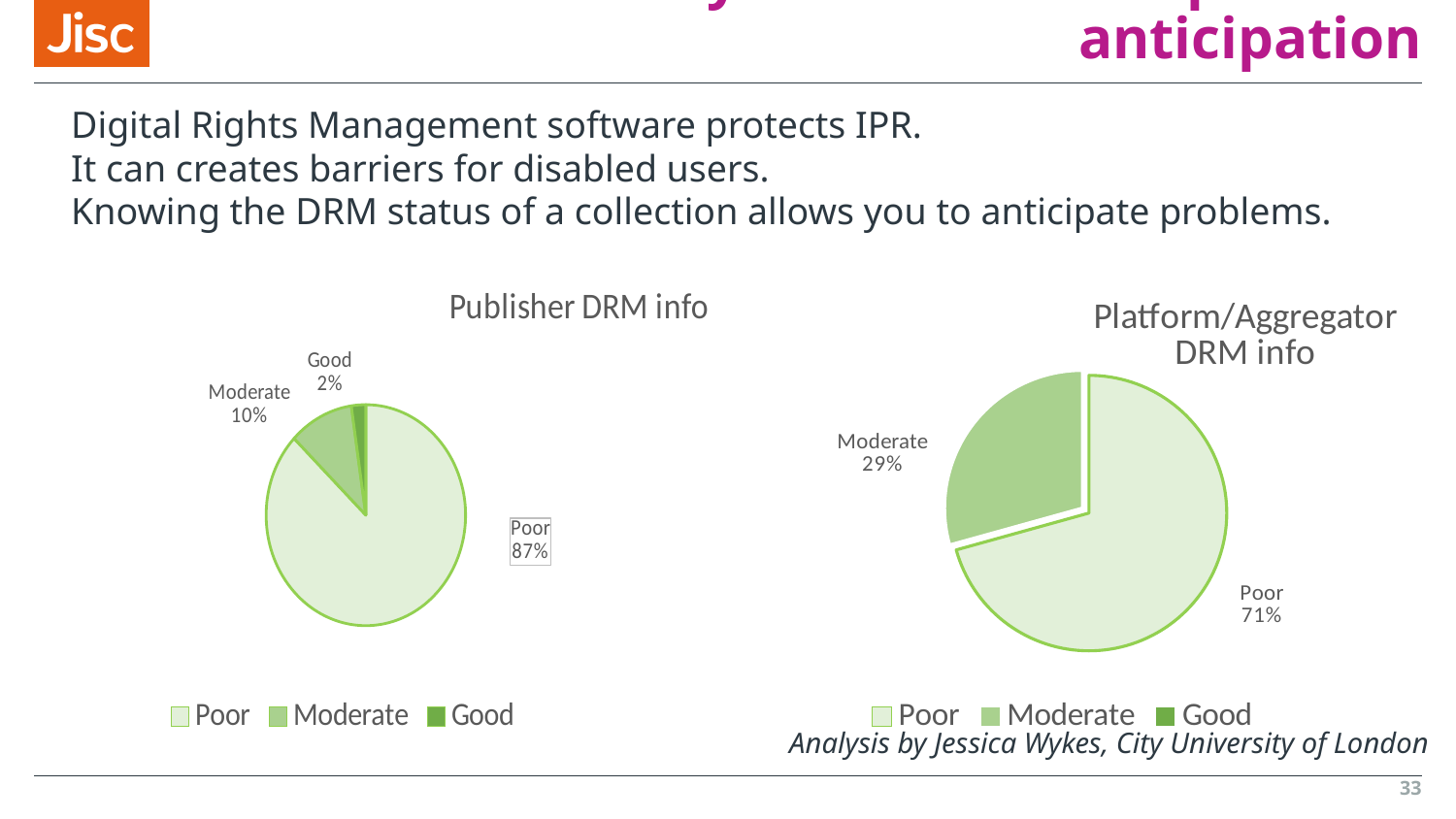
In the 'Publisher DRM info' chart, which category has the smallest slice? Good In the 'Platform/Aggregator DRM info' chart, what share is labelled Moderate? 29% In the 'Platform/Aggregator DRM info' chart, which labelled category has the smaller slice? Moderate In the 'Publisher DRM info' chart, which category has the largest slice? Poor In the 'Platform/Aggregator DRM info' chart, what is the difference between the Poor and Moderate shares? 42% In the 'Publisher DRM info' chart, what share is labelled Good? 2% In the 'Publisher DRM info' chart, what share is labelled Moderate? 10% In the 'Publisher DRM info' chart, what is the difference between the Poor and Moderate shares? 77% How many entries does the legend of the 'Platform/Aggregator DRM info' chart list? 3 In the 'Platform/Aggregator DRM info' chart, what share is labelled Poor? 71% What kind of chart is the 'Publisher DRM info' chart? Pie chart In the 'Publisher DRM info' chart, what share is labelled Poor? 87%